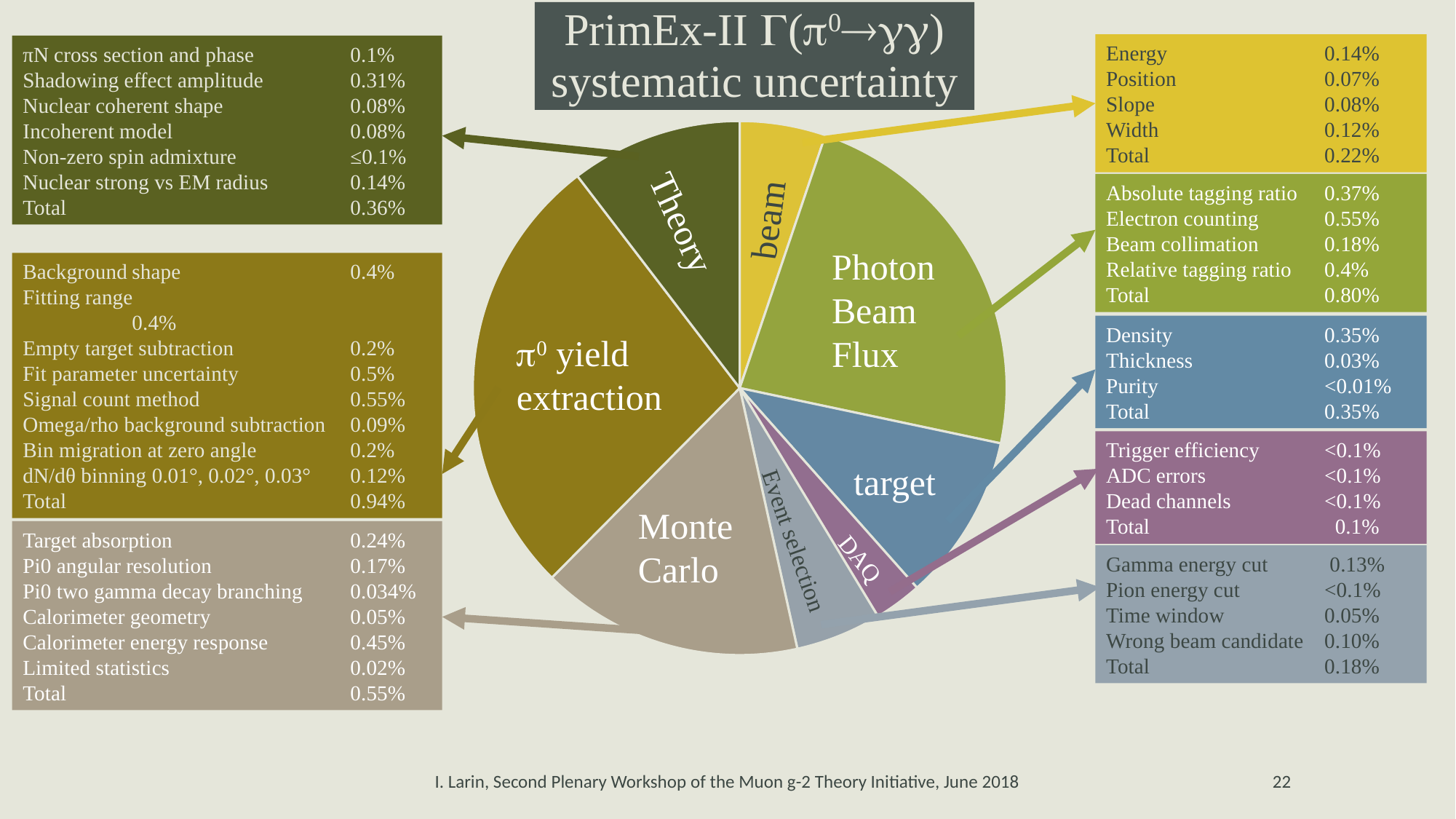
What is the total systematic uncertainty listed for the π0 yield extraction slice? 0.94% What is the total systematic uncertainty listed for the Monte Carlo slice? 0.55% What is the total systematic uncertainty listed for the Photon Beam Flux slice? 0.80% Which slice of the pie chart is the smallest? DAQ What is the total systematic uncertainty listed for the target slice? 0.35% Which slice of the pie chart is the largest? π0 yield extraction What is the title of the chart on the slide? PrimEx-II Γ(π0→γγ) systematic uncertainty Which slice is larger, Theory or beam? Theory How many slices does the pie chart have? 8 Which slice is larger, Photon Beam Flux or Monte Carlo? Photon Beam Flux What kind of chart is shown on the slide? pie chart What is the difference between the total for π0 yield extraction (0.94%) and the total for Theory (0.36%)? 0.58%